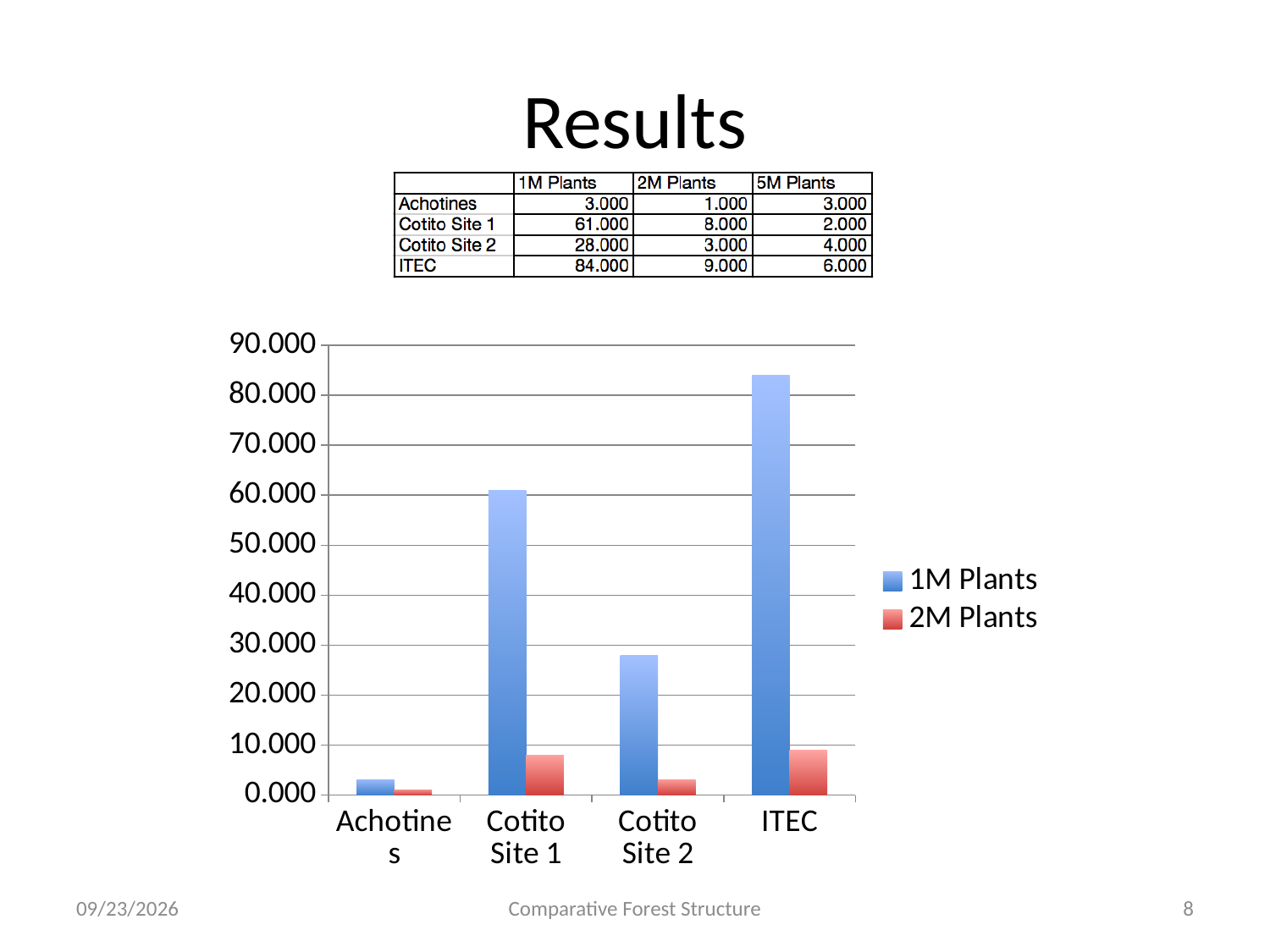
What is the value for 1M Plants at Cotito Site 1? 61.000 Which is larger, the 1M Plants value for Cotito Site 1 or for Cotito Site 2? Cotito Site 1 What kind of chart is shown on the slide? bar chart Which category has the highest value for 1M Plants? ITEC Which colour represents the 2M Plants series in the chart? red How many series does the chart legend list? 2 How many categories are shown on the x axis of the chart? 4 Is the 1M Plants value for Cotito Site 2 greater or less than 30.000? less What is the difference between the 1M Plants values for ITEC and Cotito Site 2? 56.000 Is the 1M Plants value for ITEC greater or less than 80.000? greater What is the value for 2M Plants at ITEC? 9.000 Which category has the lowest value for 1M Plants? Achotines